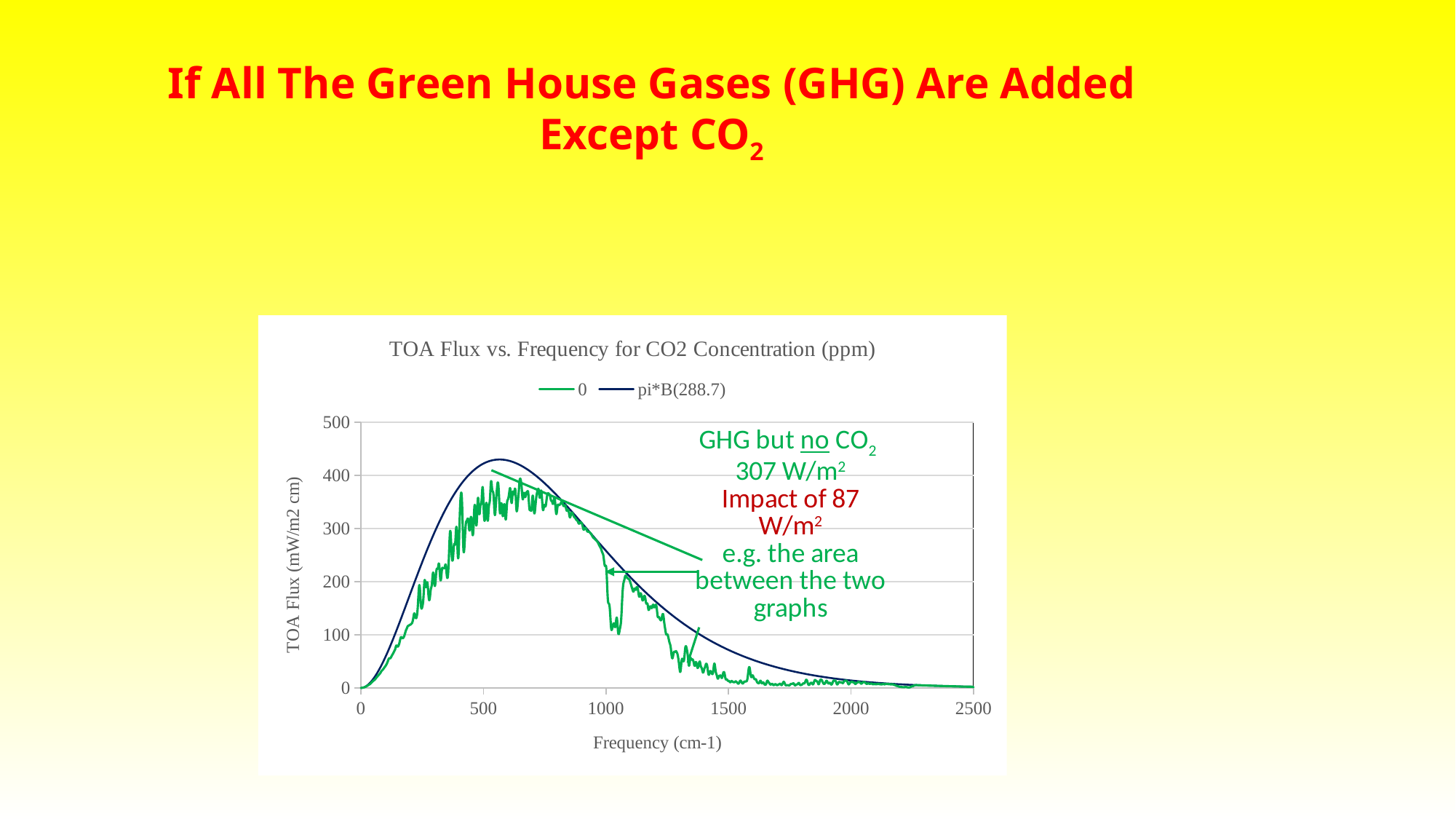
Is the peak value of the pi*B(288.7) series greater or less than 400? greater Is the value of the series labelled 0 at a frequency of 500 greater or less than 200? greater Is the value of the pi*B(288.7) series at a frequency of 2000 greater or less than 100? less Which series reaches the higher peak value, 0 or pi*B(288.7)? pi*B(288.7) Does the pi*B(288.7) series rise or fall as frequency increases from 1000 to 2500? fall Does the pi*B(288.7) series rise or fall as frequency increases from 0 to 500? rise What is the title of the chart? TOA Flux vs. Frequency for CO2 Concentration (ppm) What kind of chart is shown on the slide? line chart At a frequency of 1300, which series has the larger value, 0 or pi*B(288.7)? pi*B(288.7) How many series does the chart's legend list? 2 What is the label of the chart's x axis? Frequency (cm-1)